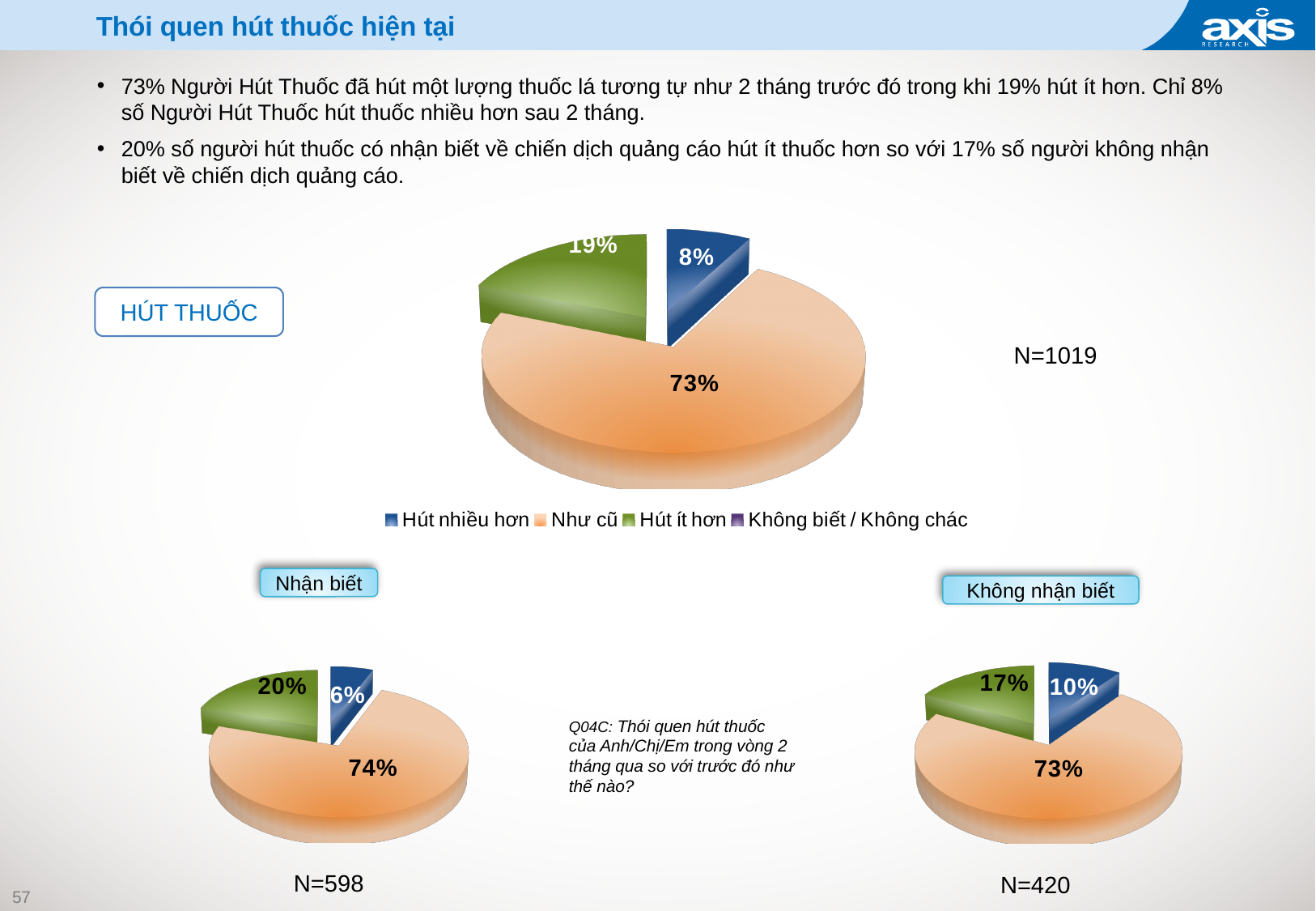
In the bottom-right pie chart (Không nhận biết, N=420), what share is labelled for the 'Hút ít hơn' slice? 17% In the bottom-left pie chart (Nhận biết, N=598), what share is labelled for the 'Hút nhiều hơn' slice? 6% In the top pie chart (HÚT THUỐC, N=1019), which labelled category has the smallest slice? Hút nhiều hơn In the top pie chart (HÚT THUỐC, N=1019), which category has the largest slice? Như cũ In the top pie chart (HÚT THUỐC, N=1019), what share is labelled for the 'Hút ít hơn' slice? 19% What type of chart is used for the HÚT THUỐC chart at the top of the slide? Pie chart What is the difference between the 'Hút ít hơn' share in the bottom-left pie chart (Nhận biết) and in the bottom-right pie chart (Không nhận biết)? 3% In the top pie chart (HÚT THUỐC, N=1019), what share is labelled for the 'Hút nhiều hơn' slice? 8% In the bottom-left pie chart (Nhận biết, N=598), what share is labelled for the 'Hút ít hơn' slice? 20% In the top pie chart (HÚT THUỐC, N=1019), what share is labelled for the 'Như cũ' slice? 73% In the bottom-right pie chart (Không nhận biết, N=420), what share is labelled for the 'Hút nhiều hơn' slice? 10% Which is larger: the 'Hút ít hơn' share in the bottom-left pie chart (Nhận biết) or in the bottom-right pie chart (Không nhận biết)? Nhận biết